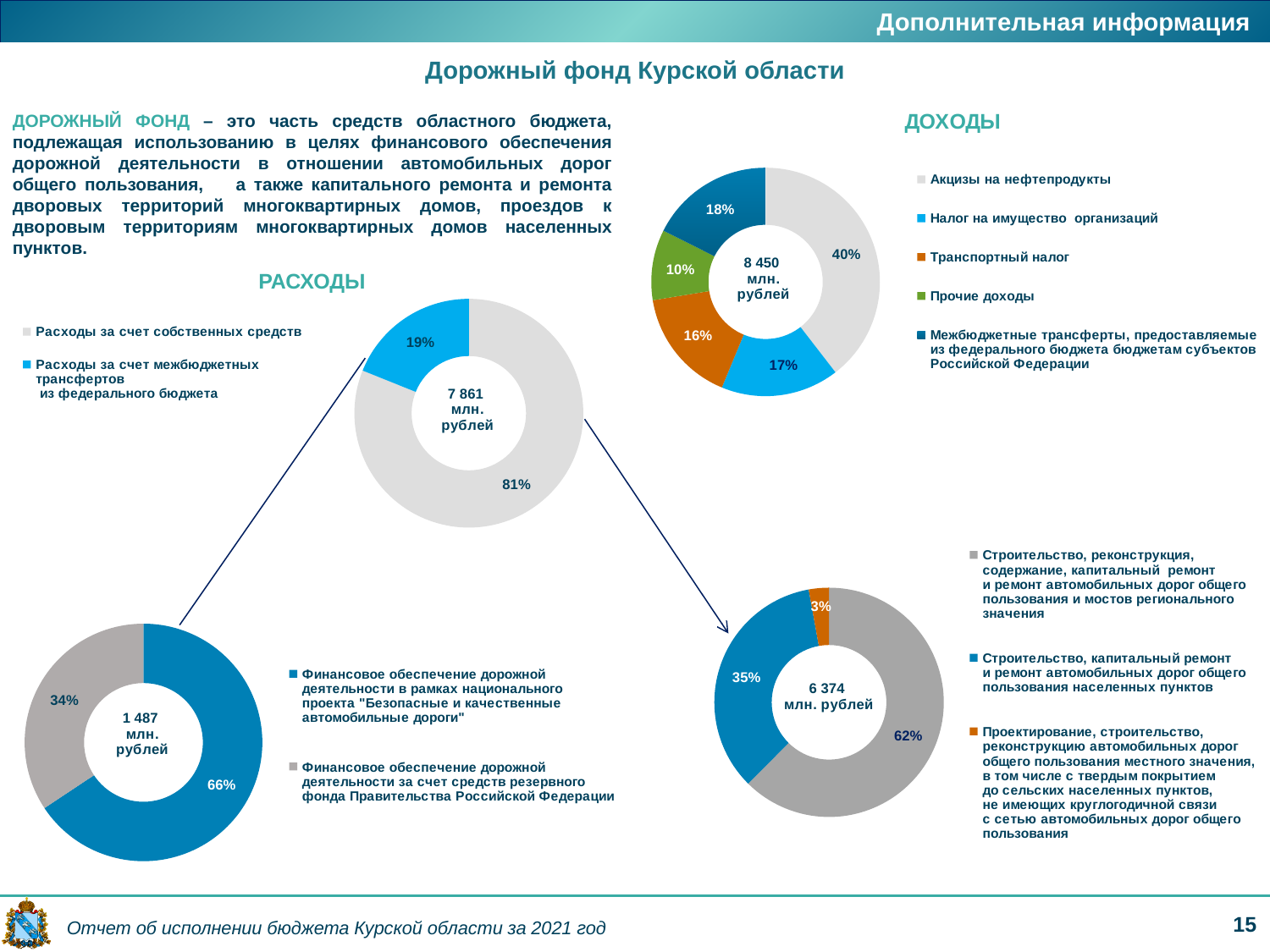
On the bottom-right chart (6 374 млн. рублей), which is larger: the share for Строительство, реконструкция, содержание, капитальный ремонт и ремонт автомобильных дорог общего пользования и мостов регионального значения or the share for Строительство, капитальный ремонт и ремонт автомобильных дорог общего пользования населенных пунктов? Строительство, реконструкция, содержание, капитальный ремонт и ремонт автомобильных дорог общего пользования и мостов регионального значения (62%) What kind of chart is used for РАСХОДЫ? Donut (pie) chart On the bottom-left chart (1 487 млн. рублей), what share is shown for Финансовое обеспечение дорожной деятельности за счет средств резервного фонда Правительства Российской Федерации? 34% On the ДОХОДЫ chart, which category has the largest share? Акцизы на нефтепродукты What total amount is shown in the centre of the ДОХОДЫ chart? 8 450 млн. рублей On the ДОХОДЫ chart, how many categories does the legend list? 5 On the ДОХОДЫ chart, what share is shown for Акцизы на нефтепродукты? 40% On the РАСХОДЫ chart, what is the difference between the shares for Расходы за счет собственных средств and Расходы за счет межбюджетных трансфертов из федерального бюджета? 62 percentage points On the РАСХОДЫ chart, what share is shown for Расходы за счет собственных средств? 81% On the ДОХОДЫ chart, which category has the smallest share? Прочие доходы On the ДОХОДЫ chart, what share is shown for Транспортный налог? 16% On the bottom-right chart (6 374 млн. рублей), which category has the smallest share? Проектирование, строительство, реконструкцию автомобильных дорог общего пользования местного значения